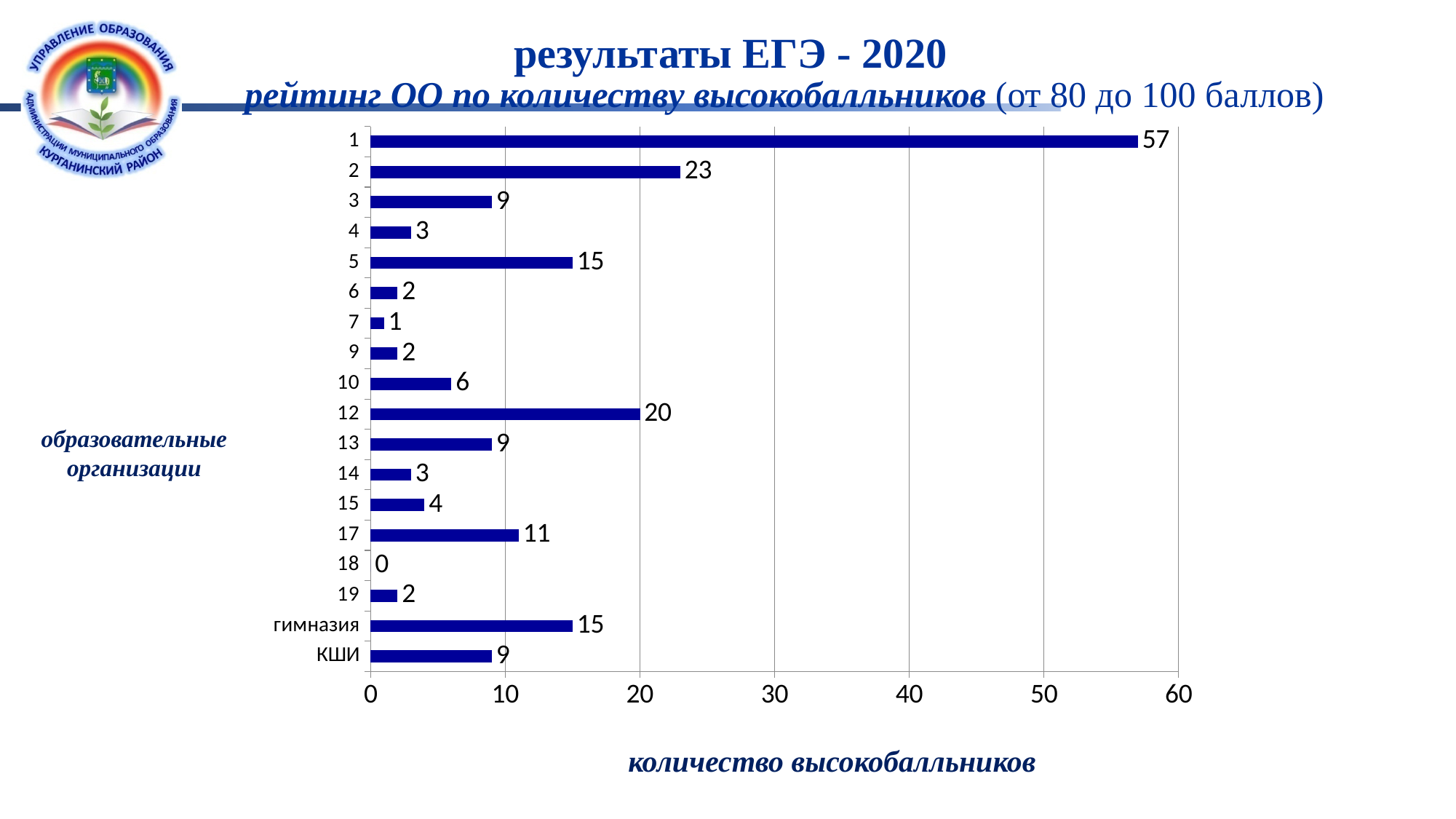
What is the value for гимназия? 15 Which category has the highest value? 1 Is the value for category 2 greater or less than 20? greater Which category has the lowest value? 18 What is the value for category 1? 57 What is the label of the horizontal axis below the chart? количество высокобалльников What is the difference between the values for category 1 and category 2? 34 What is the value for category 12? 20 What is the value for КШИ? 9 What kind of chart is shown on the slide? bar chart Which is larger, the value for category 5 or the value for category 17? category 5 How many categories are shown on the chart? 18